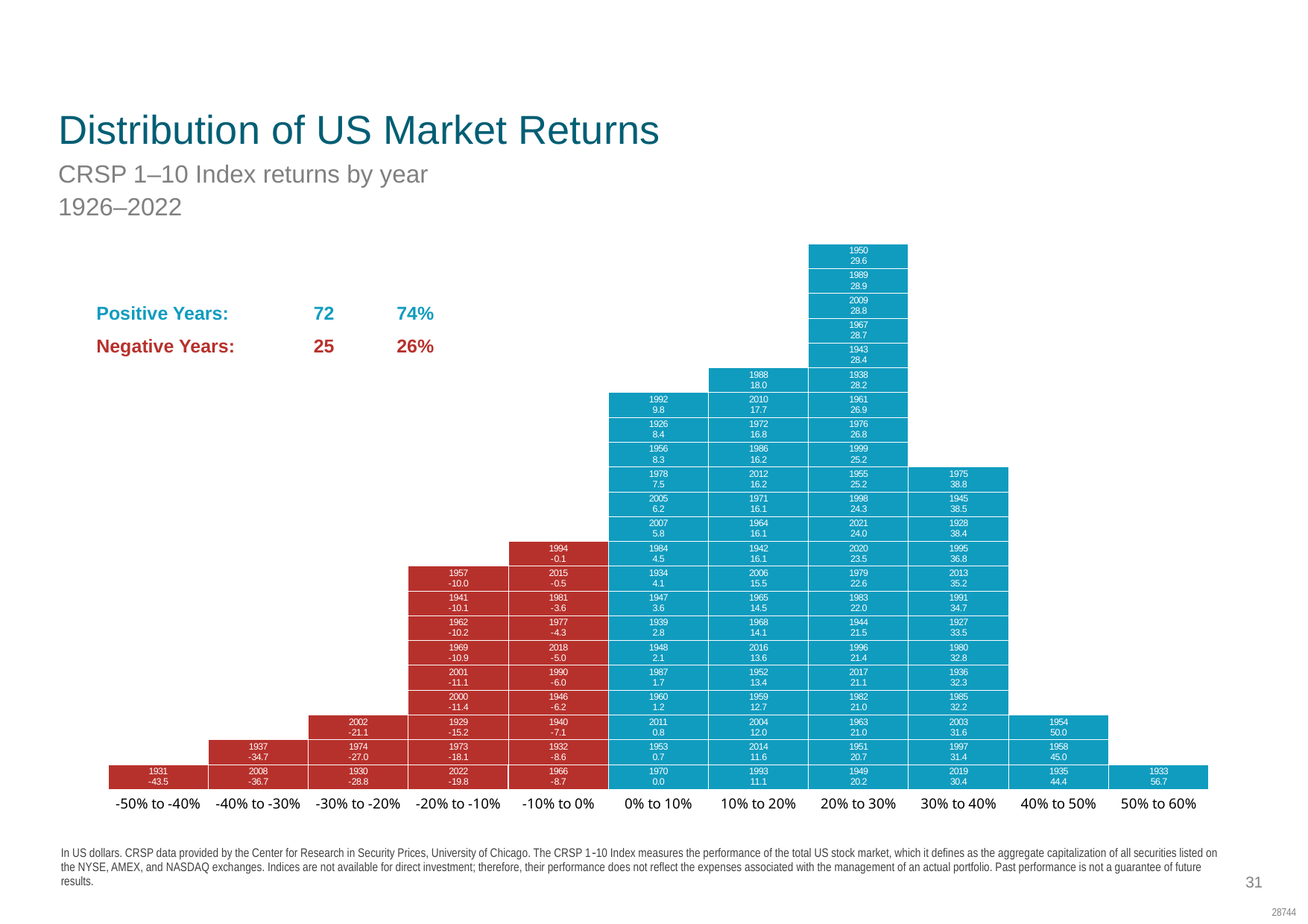
What was the CRSP 1-10 Index return for 1933? 56.7 Which return range contains the most years? 20% to 30% How many positive years does the slide report, and what percentage is that? 72, 74% How many return ranges are shown along the x axis? 11 Which year had the lowest return shown on the chart? 1931 What was the return for 2008? -36.7 What was the return for 1931? -43.5 What is the difference between the returns for 1933 and 1954? 6.7 How many years fall in the 40% to 50% range? 3 What was the return for 2022? -19.8 Which year had the highest return shown on the chart? 1933 Which year had the lower return, 2008 or 1937? 2008